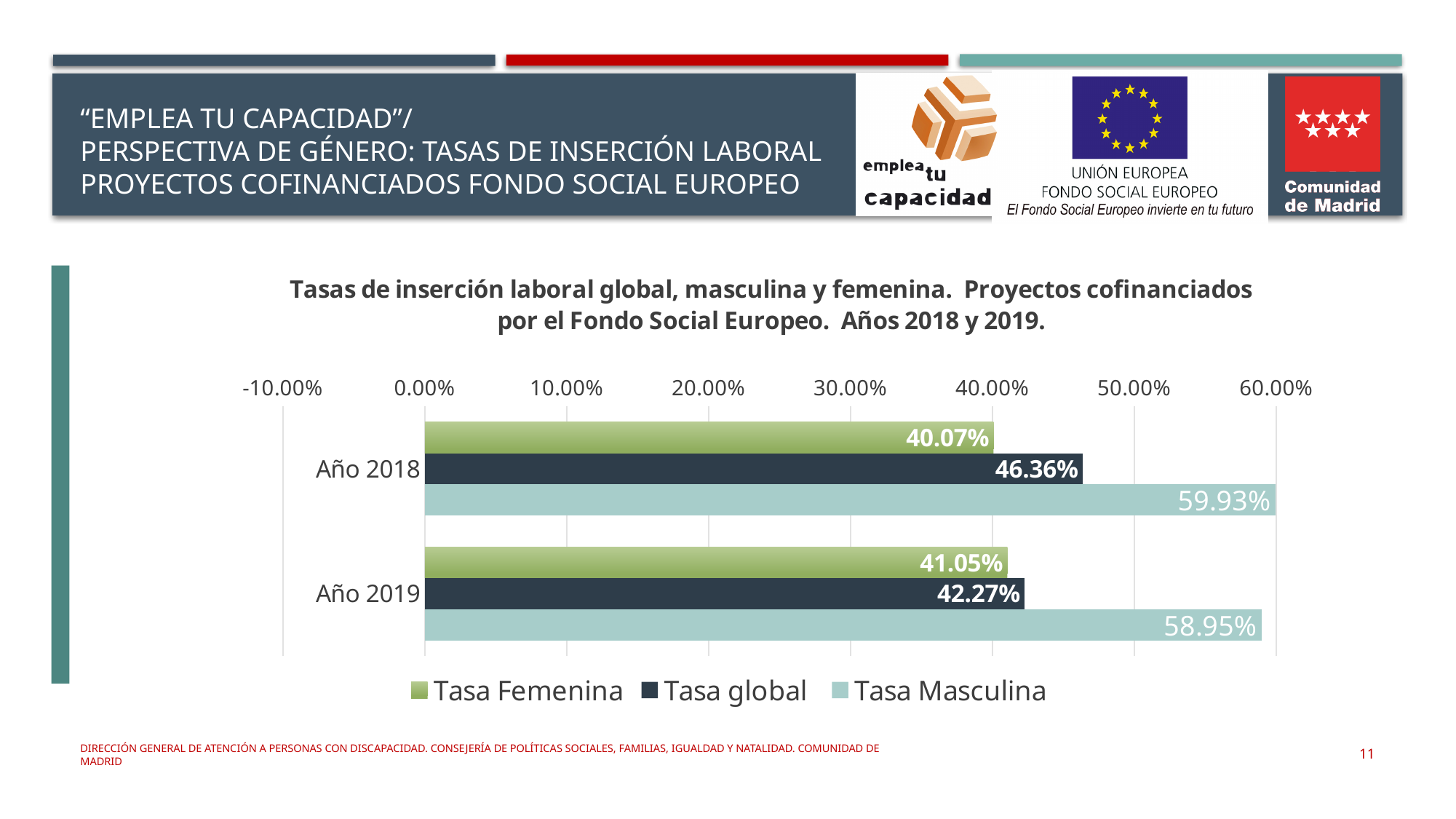
Which is larger, the Tasa Femenina for Año 2018 or for Año 2019? Año 2019 What is the Tasa Masculina value for Año 2019? 58.95% What is the Tasa global value for Año 2019? 42.27% What is the Tasa Femenina value for Año 2018? 40.07% How many year categories are shown on the chart? 2 What is the difference between Tasa Masculina and Tasa Femenina for Año 2018? 19.86% What kind of chart is shown on the slide? Bar chart Which series has the highest value for Año 2019? Tasa Masculina What is the Tasa Masculina value for Año 2018? 59.93% How many series does the legend list? 3 Which series has the lowest value for Año 2018? Tasa Femenina What is the difference between the Tasa global values for Año 2018 and Año 2019? 4.09%